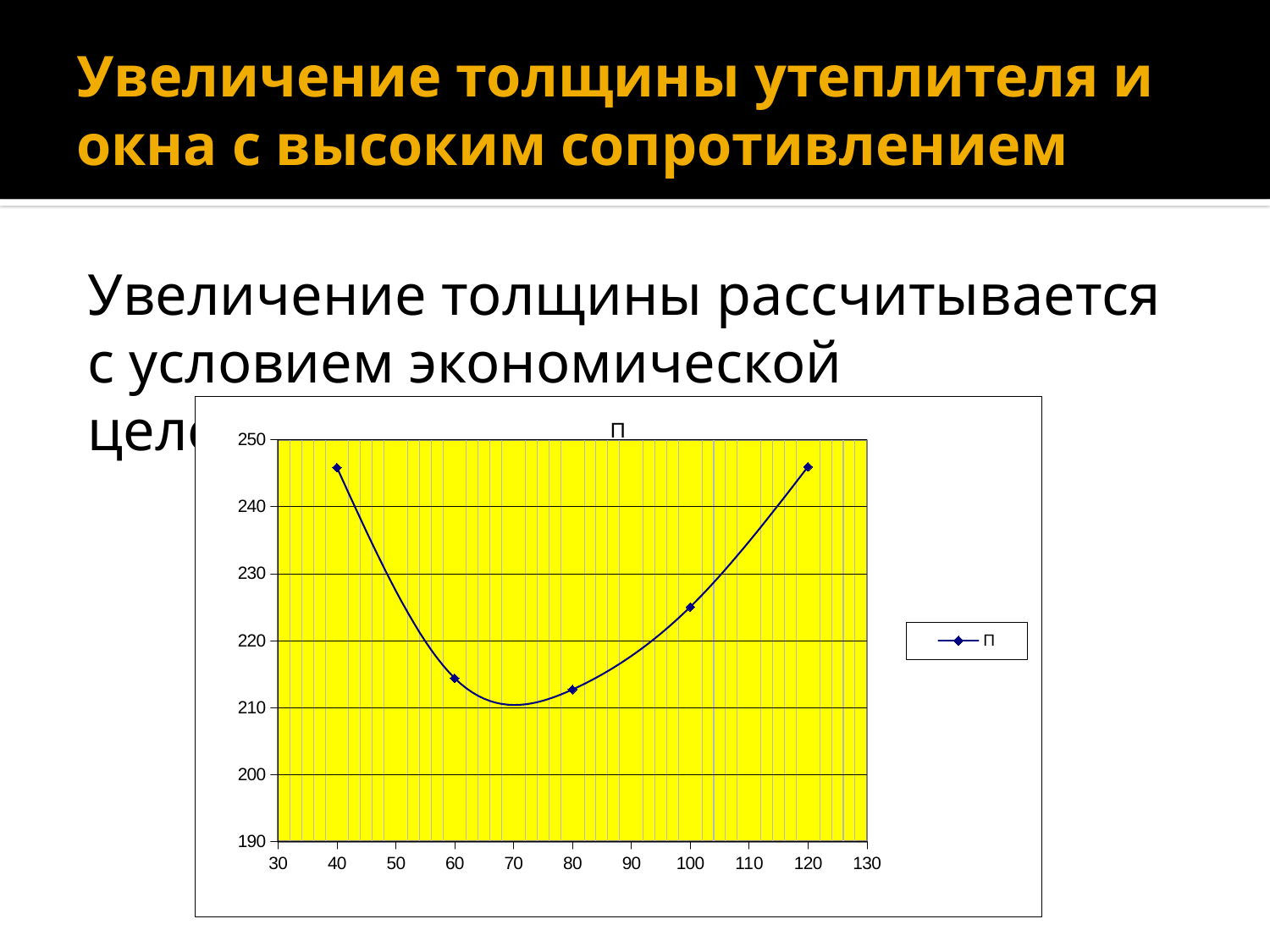
Is the value at x = 80 greater or less than 220? less How many series does the legend list? 1 Is the value at x = 100 greater or less than 220? greater Which is larger, the value at x = 60 or the value at x = 100? x = 100 How many data points are plotted on the chart? 5 Is the value at x = 120 greater or less than 240? greater What is the title of the chart? П What is the name of the series shown in the legend? П What kind of chart is shown on the slide? line chart How do the values change as x increases from 40 to 120? they fall, then rise